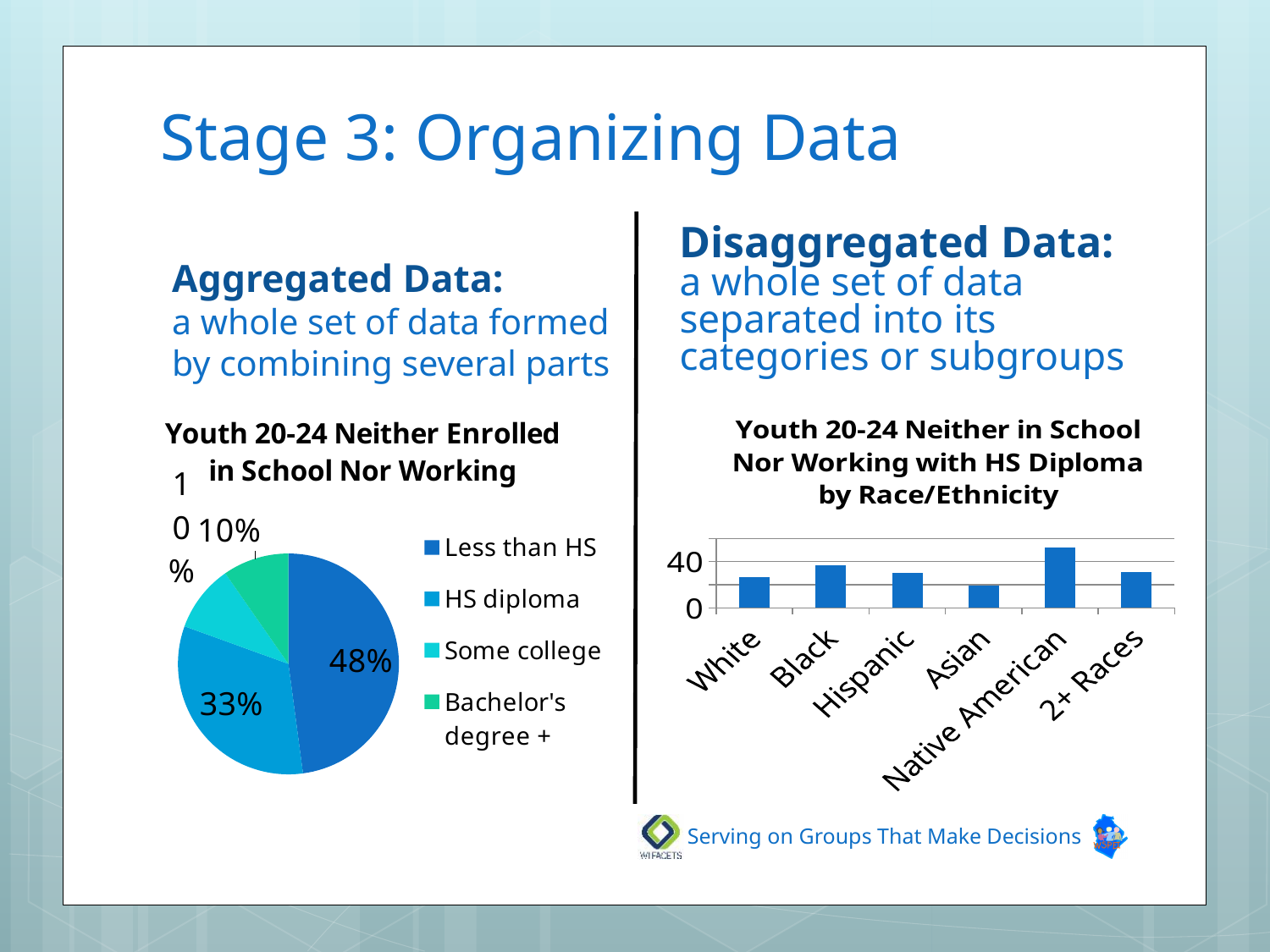
On the bar chart 'Youth 20-24 Neither in School Nor Working with HS Diploma by Race/Ethnicity', which category has the highest bar? Native American What kind of chart is the one titled 'Youth 20-24 Neither in School Nor Working with HS Diploma by Race/Ethnicity'? Bar chart On the bar chart 'Youth 20-24 Neither in School Nor Working with HS Diploma by Race/Ethnicity', which category has the lowest bar? Asian On the bar chart 'Youth 20-24 Neither in School Nor Working with HS Diploma by Race/Ethnicity', how many race/ethnicity categories are shown? 6 On the pie chart 'Youth 20-24 Neither Enrolled in School Nor Working', what share is labelled for HS diploma? 33% On the bar chart 'Youth 20-24 Neither in School Nor Working with HS Diploma by Race/Ethnicity', is the value for Asian greater or less than 40? less On the bar chart 'Youth 20-24 Neither in School Nor Working with HS Diploma by Race/Ethnicity', is the value for Native American greater or less than 40? greater On the pie chart 'Youth 20-24 Neither Enrolled in School Nor Working', which is larger, the Less than HS slice or the HS diploma slice? Less than HS On the pie chart 'Youth 20-24 Neither Enrolled in School Nor Working', which category has the largest slice? Less than HS On the pie chart 'Youth 20-24 Neither Enrolled in School Nor Working', what share is labelled for Less than HS? 48% On the pie chart 'Youth 20-24 Neither Enrolled in School Nor Working', what is the difference between the Less than HS and HS diploma shares? 15% On the pie chart 'Youth 20-24 Neither Enrolled in School Nor Working', how many categories does the legend list? 4